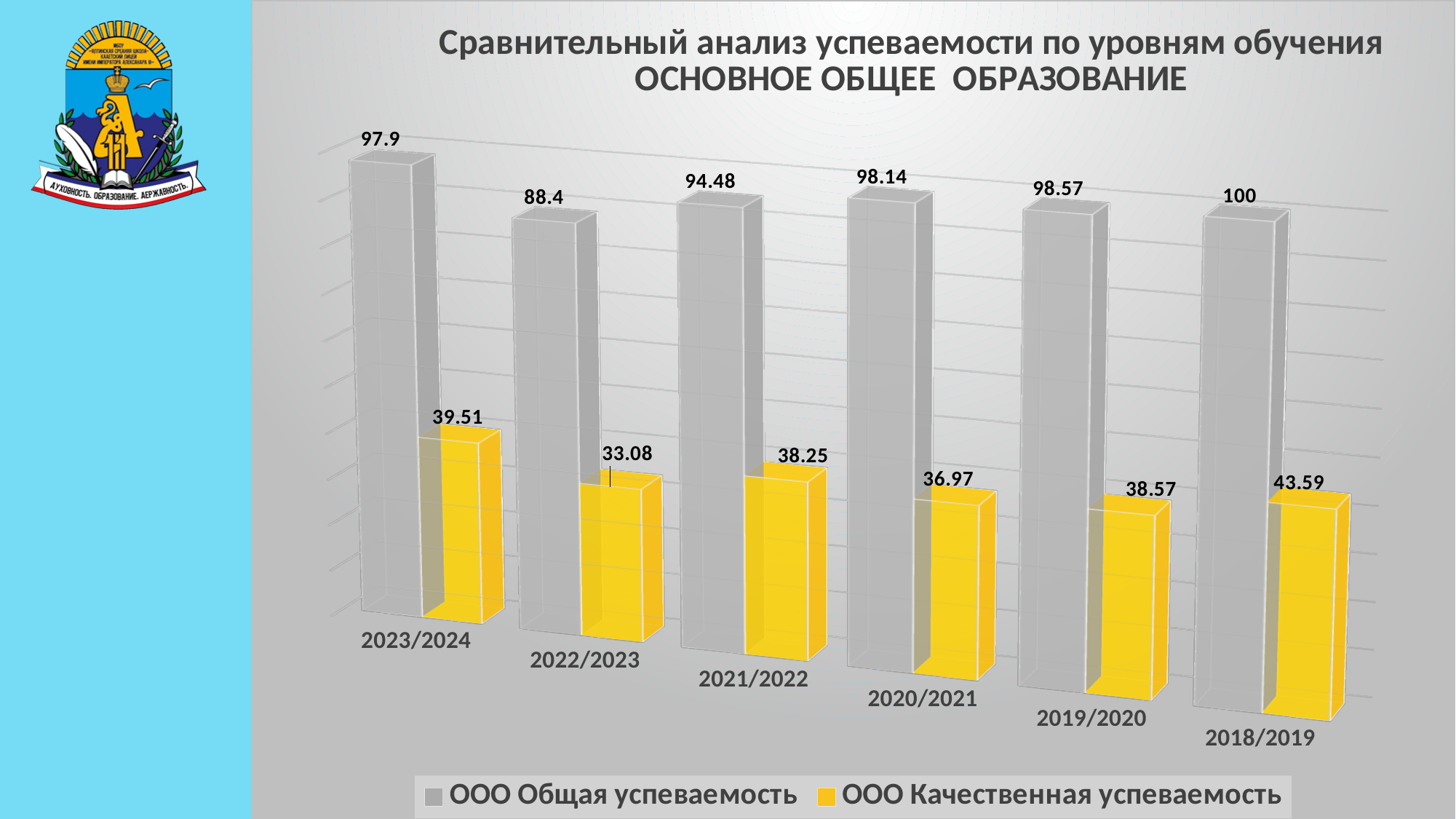
What is the value of ООО Качественная успеваемость for 2022/2023? 33.08 How many years (categories) are shown on the chart? 6 Which is larger: ООО Качественная успеваемость for 2023/2024 or for 2021/2022? 2023/2024 Which colour represents ООО Качественная успеваемость in the chart? Yellow Which year has the lowest value for ООО Общая успеваемость? 2022/2023 What kind of chart is shown on the slide? Bar chart What is the value of ООО Качественная успеваемость for 2018/2019? 43.59 What is the difference between ООО Общая успеваемость and ООО Качественная успеваемость for 2020/2021? 61.17 What is the value of ООО Общая успеваемость for 2023/2024? 97.9 Which year has the lowest value for ООО Качественная успеваемость? 2022/2023 How many series does the legend list? 2 Which year has the highest value for ООО Общая успеваемость? 2018/2019